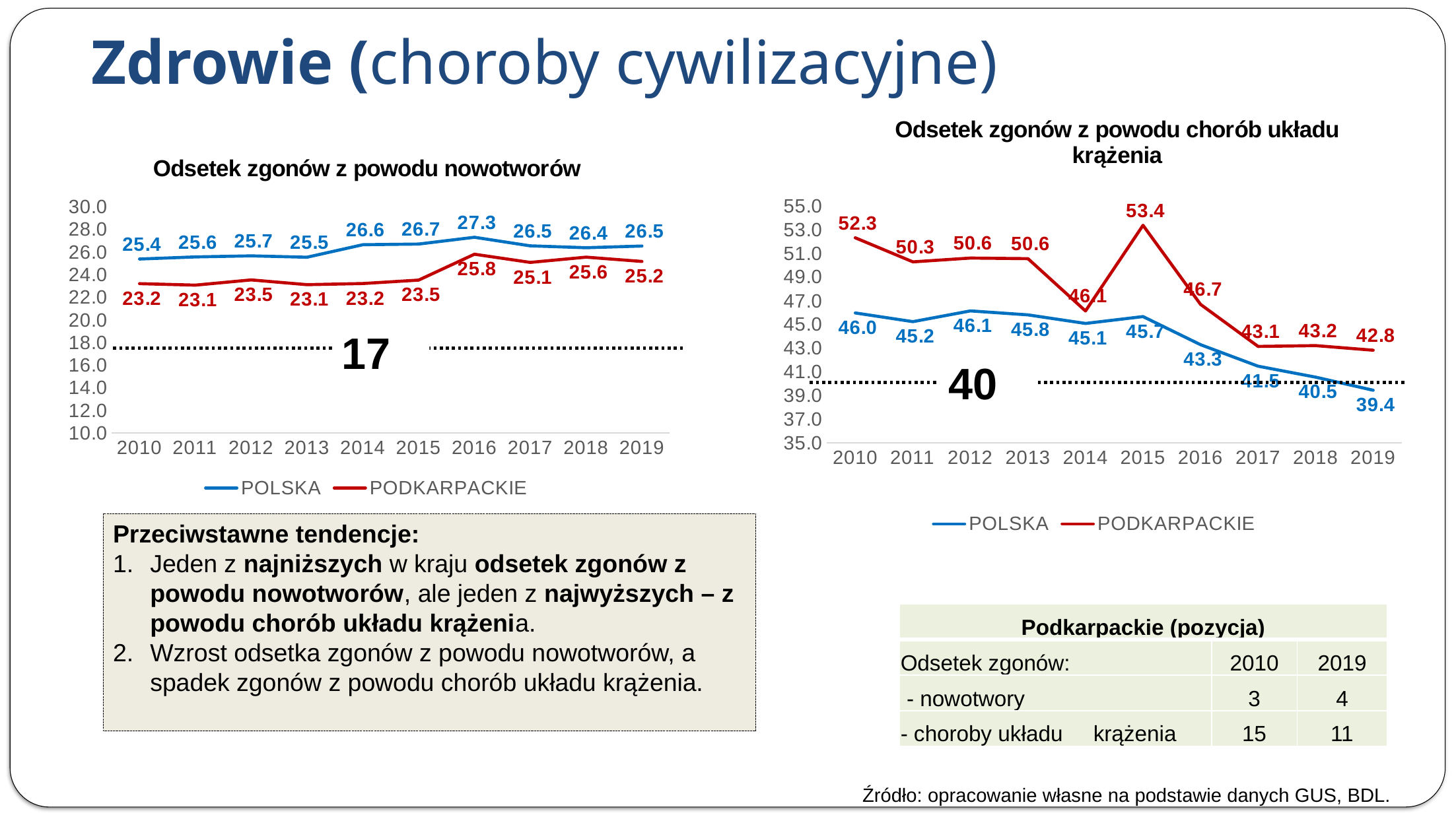
In the chart 'Odsetek zgonów z powodu nowotworów', what is the value for PODKARPACKIE in 2019? 25.2 In the chart 'Odsetek zgonów z powodu chorób układu krążenia', does the POLSKA series generally rise or fall from 2010 to 2019? fall What type of chart is 'Odsetek zgonów z powodu chorób układu krążenia'? line chart How many years are shown on the x axis of the chart 'Odsetek zgonów z powodu nowotworów'? 10 In the chart 'Odsetek zgonów z powodu chorób układu krążenia', what is the difference between PODKARPACKIE in 2010 and PODKARPACKIE in 2019? 9.5 In the chart 'Odsetek zgonów z powodu chorób układu krążenia', in which year does the POLSKA series have its lowest value? 2019 In the chart 'Odsetek zgonów z powodu nowotworów', what is the difference between POLSKA and PODKARPACKIE in 2010? 2.2 In the chart 'Odsetek zgonów z powodu chorób układu krążenia', which series has the larger value in 2014, POLSKA or PODKARPACKIE? PODKARPACKIE In the chart 'Odsetek zgonów z powodu chorób układu krążenia', what is the value for POLSKA in 2019? 39.4 In the chart 'Odsetek zgonów z powodu nowotworów', what is the value for POLSKA in 2016? 27.3 In the chart 'Odsetek zgonów z powodu nowotworów', in which year does the POLSKA series reach its highest value? 2016 In the chart 'Odsetek zgonów z powodu chorób układu krążenia', what is the value for PODKARPACKIE in 2015? 53.4